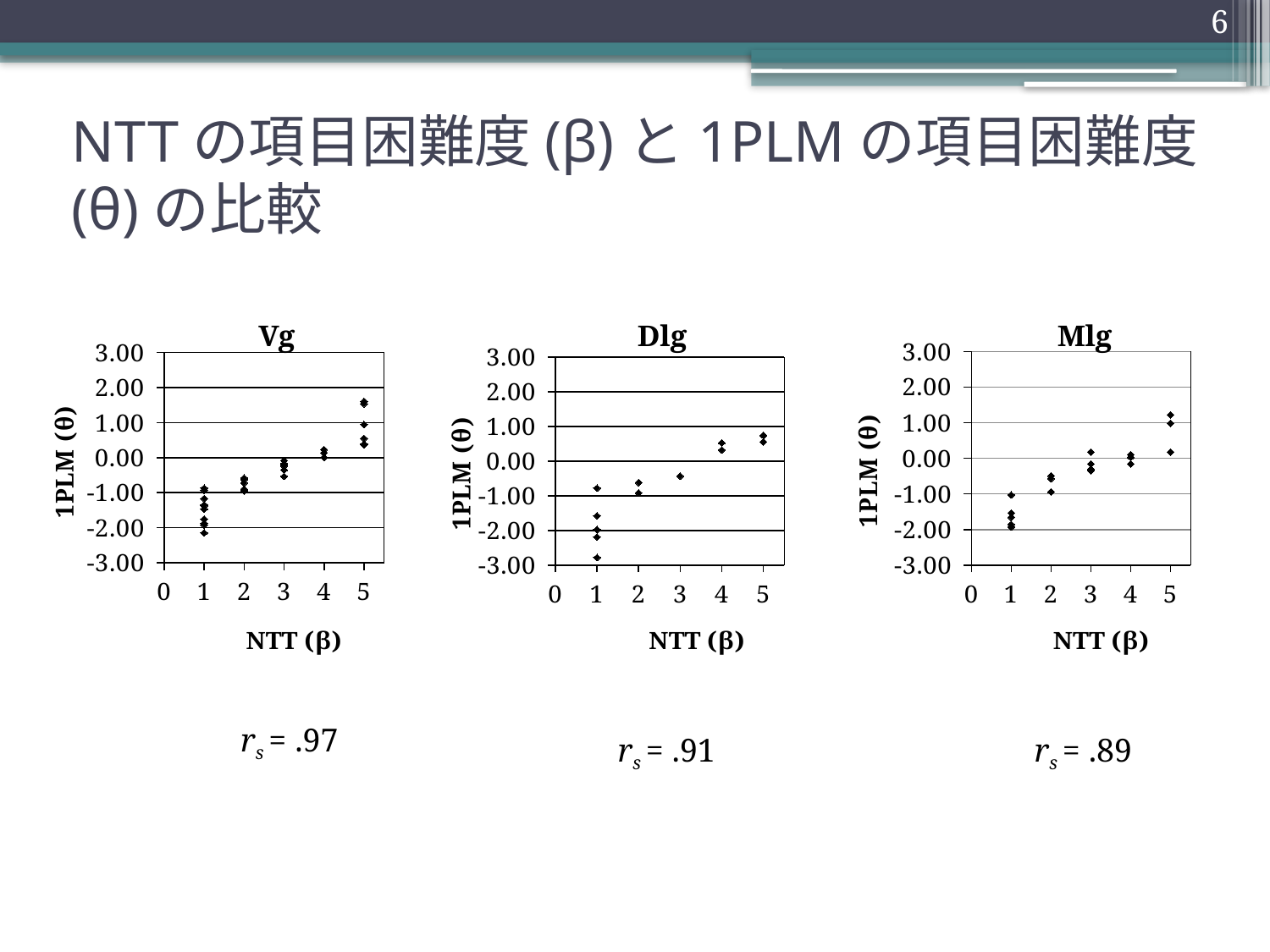
In the Dlg chart, at which NTT (β) value does the lowest 1PLM (θ) point occur? 1 How many charts are shown on the slide? 3 In the Mlg chart, are the 1PLM (θ) values at NTT (β) = 5 greater or less than 0.00? greater In the Vg chart, are the 1PLM (θ) values at NTT (β) = 5 greater or less than 0.00? greater In the Vg chart, are the 1PLM (θ) values at NTT (β) = 1 greater or less than 0.00? less What kind of chart is the Vg chart? scatter chart In the Vg chart, do the 1PLM (θ) values rise or fall as NTT (β) increases? rise In the Vg chart, at which NTT (β) value does the highest 1PLM (θ) point occur? 5 What is the title of the y axis on the Mlg chart? 1PLM (θ) In the Mlg chart, do the 1PLM (θ) values rise or fall as NTT (β) increases? rise In the Dlg chart, do the 1PLM (θ) values rise or fall as NTT (β) increases? rise